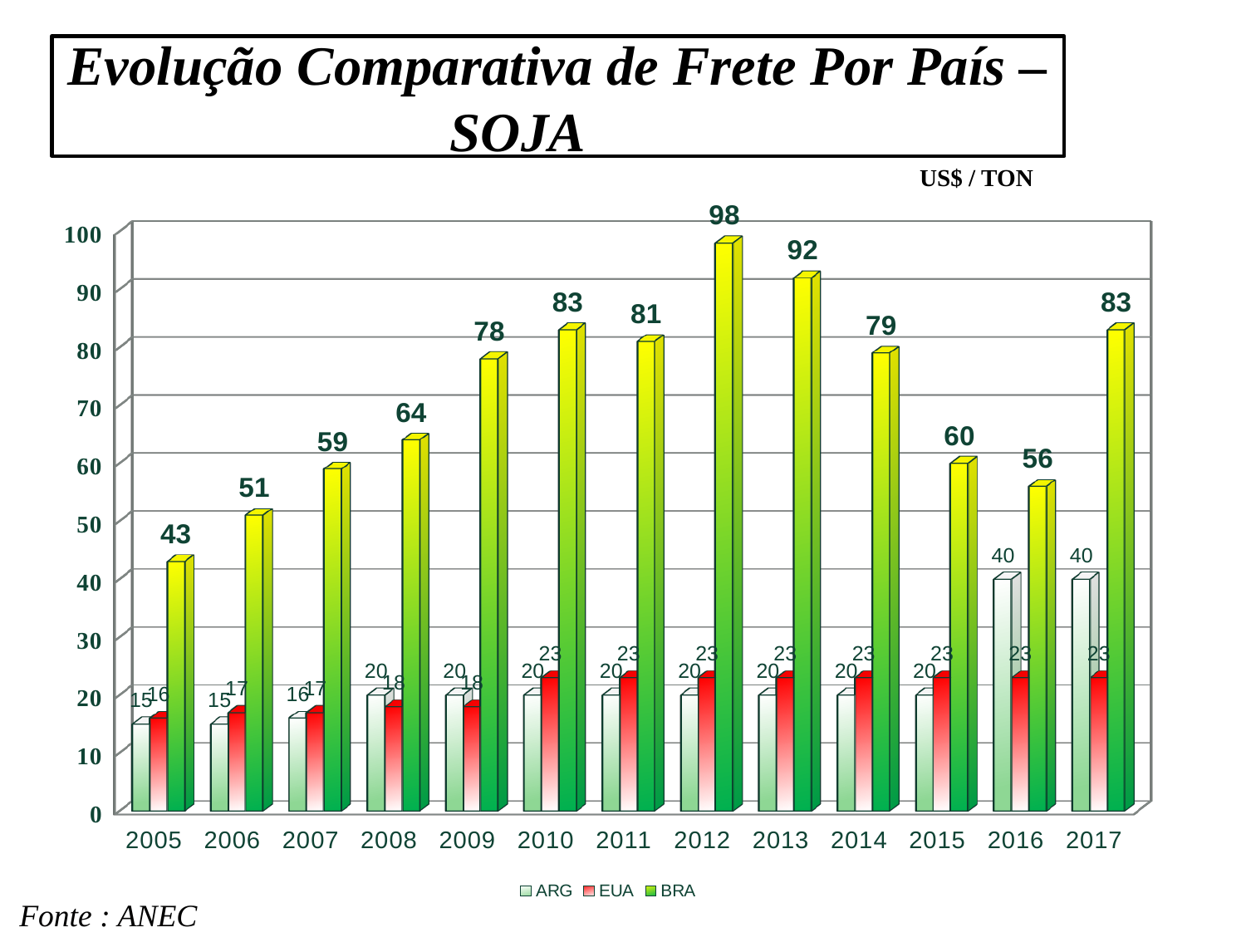
In which year is the BRA value highest? 2012 In which year is the BRA value lowest? 2005 What is the BRA value for 2012? 98 Does the BRA value rise or fall from 2005 to 2012? rise What is the ARG value for 2016? 40 What unit is shown above the chart? US$ / TON How many years are shown on the x axis? 13 What is the difference between the BRA values for 2012 and 2013? 6 Which is larger, the BRA value for 2009 or the BRA value for 2014? 2014 How many series does the legend list? 3 What is the EUA value for 2008? 18 What kind of chart is shown on the slide? bar chart